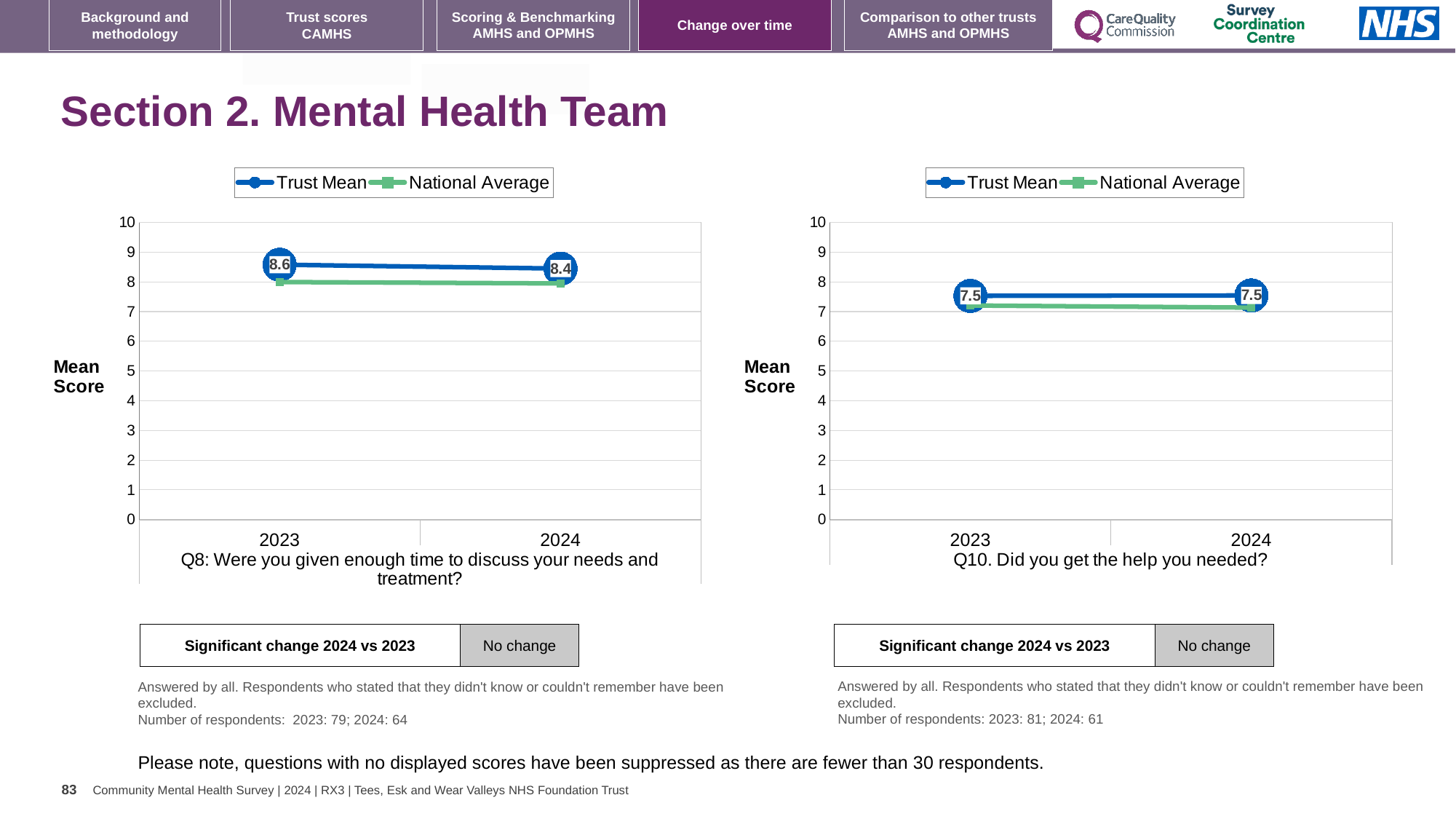
In the Q10 chart (right), does the Trust Mean rise, fall or stay the same from 2023 to 2024? stay the same How many series does the legend of the Q8 chart (left) list? 2 How many years are plotted on the x axis of the Q10 chart (right)? 2 What are the two series named in the legend of the Q10 chart (right)? Trust Mean and National Average In the Q8 chart (left), which is larger in 2023: the Trust Mean or the National Average? Trust Mean In the Q10 chart (right), is the National Average for 2023 greater or less than 8? less In the Q8 chart (left), does the Trust Mean rise or fall from 2023 to 2024? fall What kind of chart is the Q10 chart (right)? line chart In the Q8 chart (left), what is the Trust Mean score for 2023? 8.6 In the Q8 chart (left), by how much did the Trust Mean change from 2023 to 2024? decreased by 0.2 In the Q8 chart (left), what is the Trust Mean score for 2024? 8.4 In the Q10 chart (right), what is the Trust Mean score for 2024? 7.5